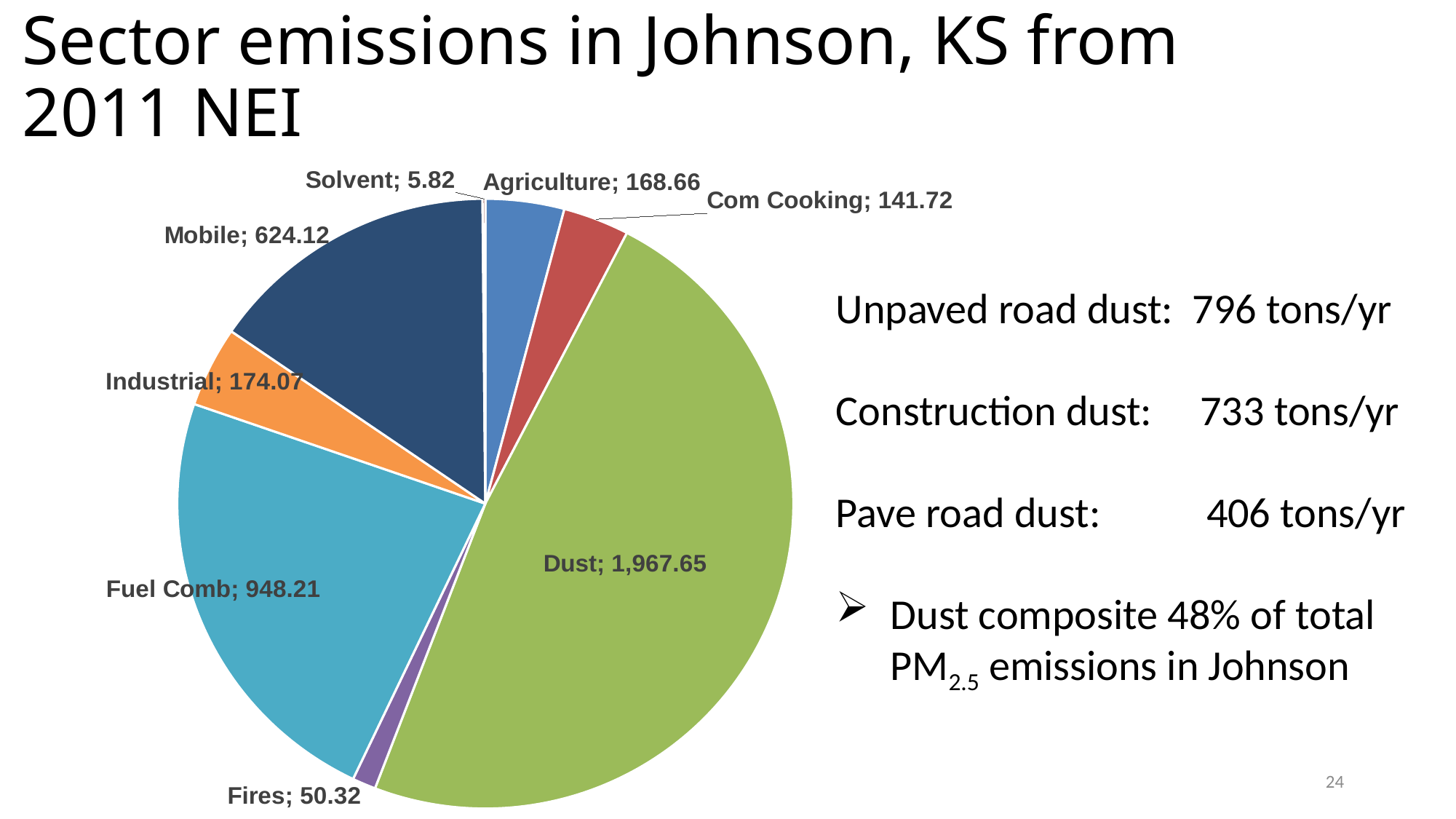
What share of total PM2.5 emissions does Dust make up, according to the slide? 48% What type of chart is shown on the slide? pie chart Which sector has the largest slice in the pie chart? Dust What is the value for Mobile in the pie chart? 624.12 What is the value for Dust in the pie chart? 1,967.65 Which sector has the smallest slice in the pie chart? Solvent What is the value for Fuel Comb in the pie chart? 948.21 What is the title of the slide containing the pie chart? Sector emissions in Johnson, KS from 2011 NEI What is the difference between the Fuel Comb and Mobile values? 324.09 How many sectors (slices) does the pie chart show? 8 Which is larger, the value for Mobile or the value for Industrial? Mobile What is the value for Com Cooking in the pie chart? 141.72